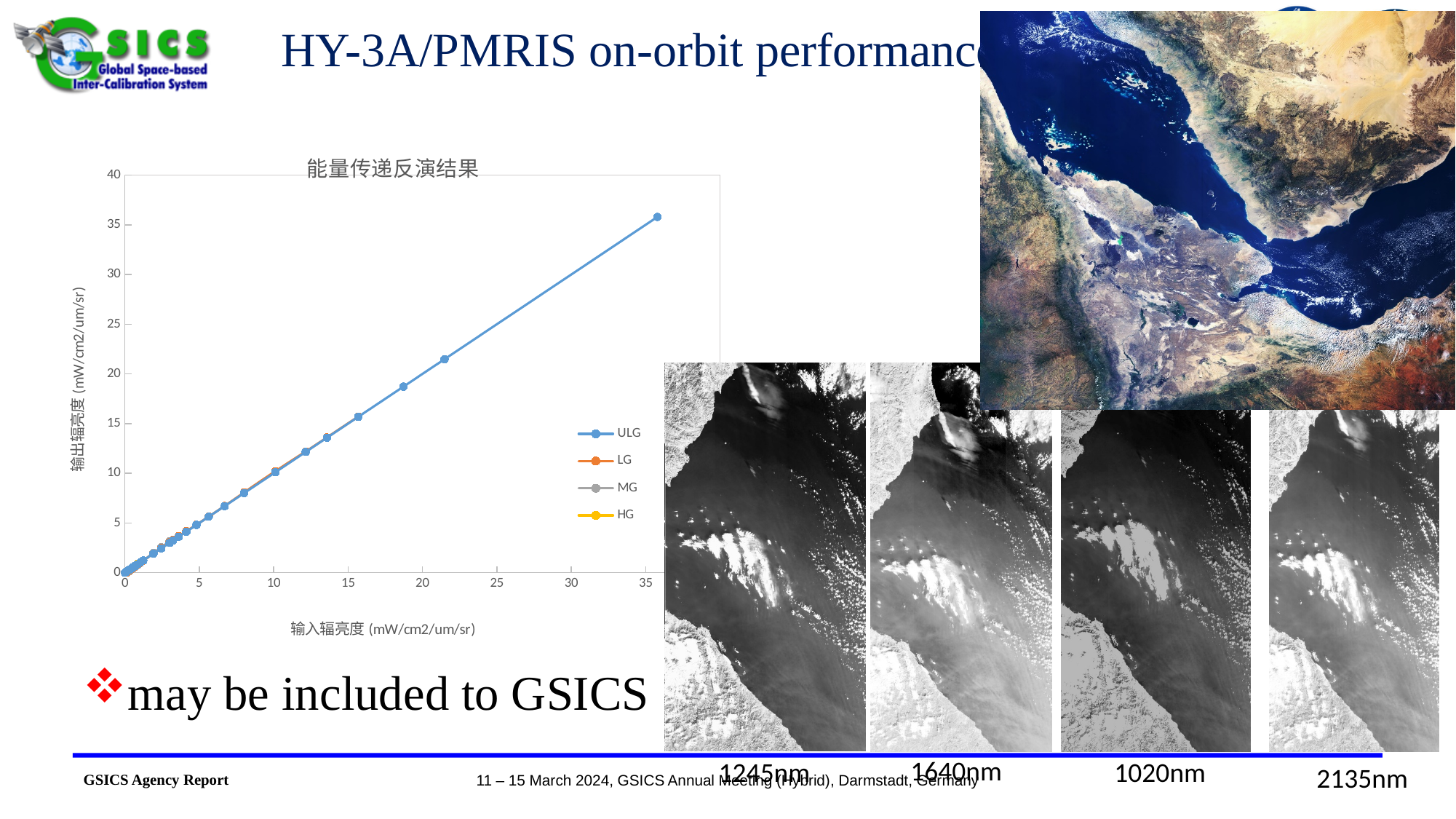
Is the output radiance of the plotted point near an input radiance of 21 greater or less than 25? less What are the series names listed in the chart legend? ULG, LG, MG, HG What kind of chart is shown on the left of the slide? line chart How many series does the legend of the chart list? 4 Is the output radiance of the plotted point near an input radiance of 10 greater or less than 15? less What is the title of the chart? 能量传递反演结果 What is the maximum value shown on the y axis of the chart? 40 Do the plotted output radiance values rise or fall as input radiance increases along the x axis? rise Is the output radiance of the rightmost plotted point (at the highest input radiance) greater or less than 30? greater